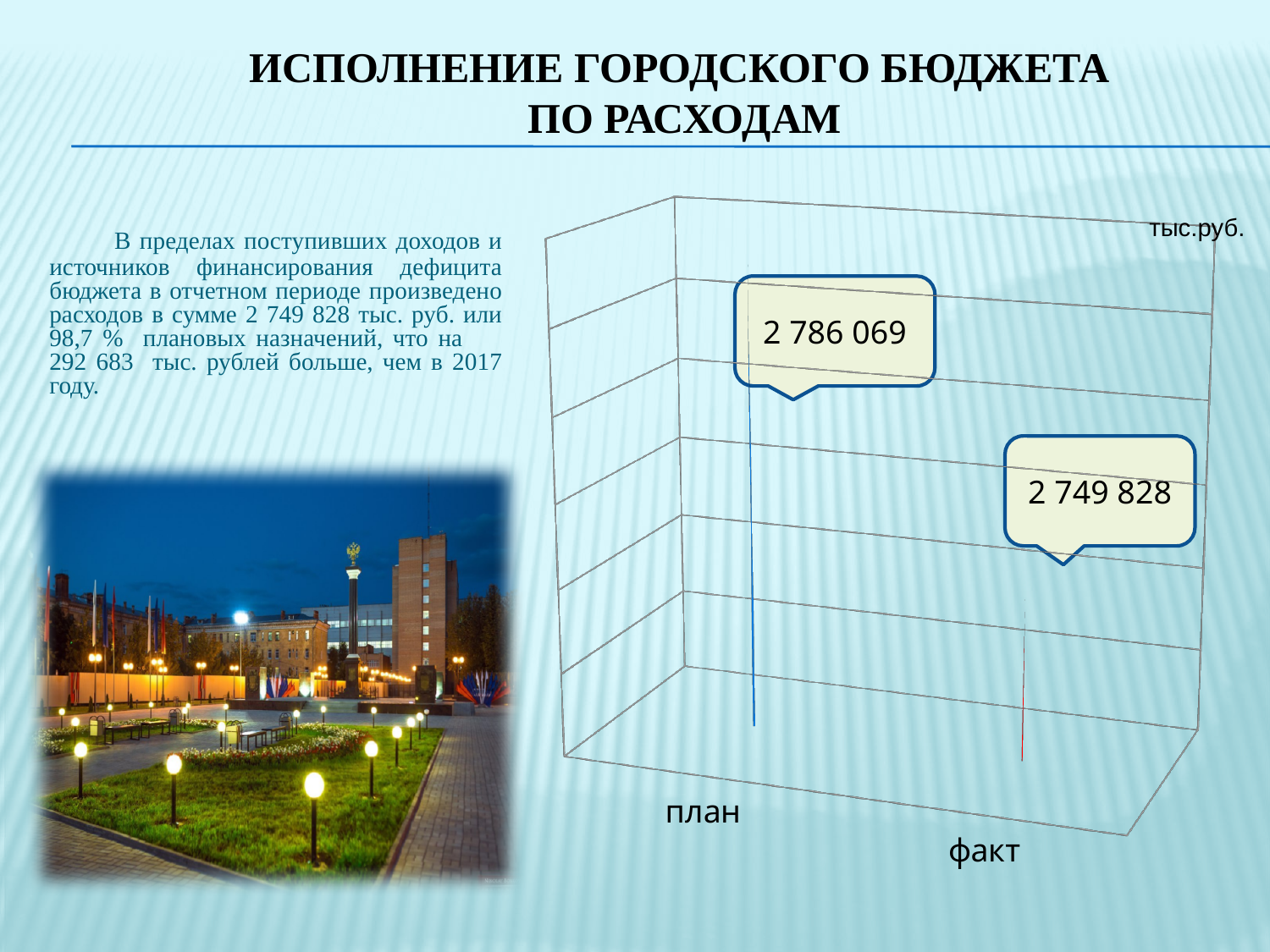
How many categories are shown on the chart? 2 What kind of chart is shown on the slide? bar chart What are the two category labels along the bottom of the chart? план and факт Which category has the higher value, план or факт? план Is the value for факт larger or smaller than the value for план? smaller What is the value for факт on the chart? 2 749 828 Which category has the lowest value on the chart? факт What unit label is shown at the top of the chart? тыс.руб. What is the value for план on the chart? 2 786 069 What is the difference between the план value and the факт value? 36 241